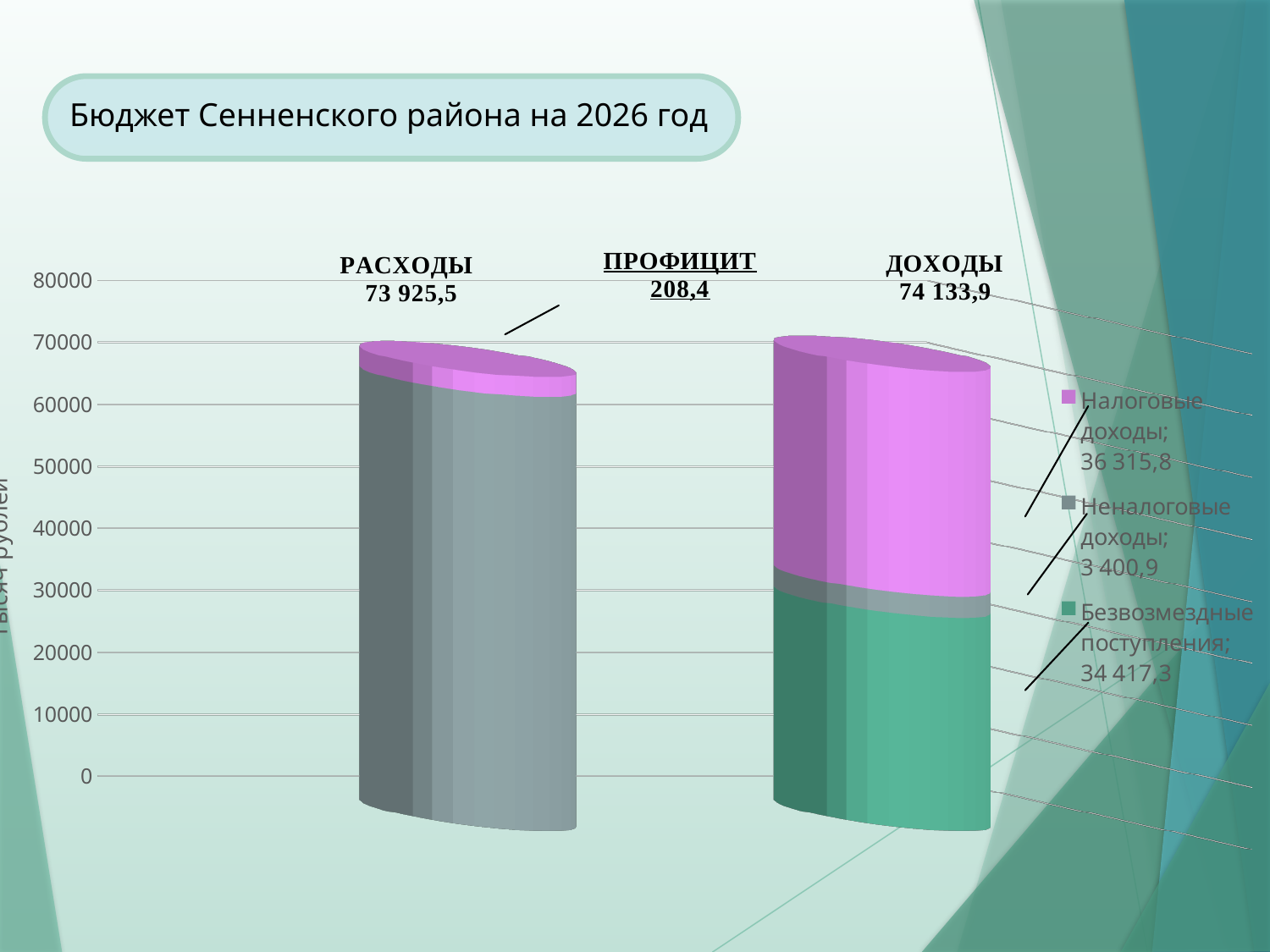
What is the value of Безвозмездные поступления in the legend? 34 417,3 What is the value of Неналоговые доходы in the legend? 3 400,9 What is the value labelled ПРОФИЦИТ on the chart? 208,4 What is the difference between ДОХОДЫ and РАСХОДЫ? 208,4 Which of the three income components in the legend has the smallest value? Неналоговые доходы What kind of chart is shown on the slide? bar chart What is the value of Налоговые доходы in the legend? 36 315,8 What is the value shown for РАСХОДЫ? 73 925,5 What is the value shown for ДОХОДЫ? 74 133,9 Which is larger, РАСХОДЫ or ДОХОДЫ? ДОХОДЫ Which of the three income components in the legend has the largest value? Налоговые доходы How many series does the legend list? 3